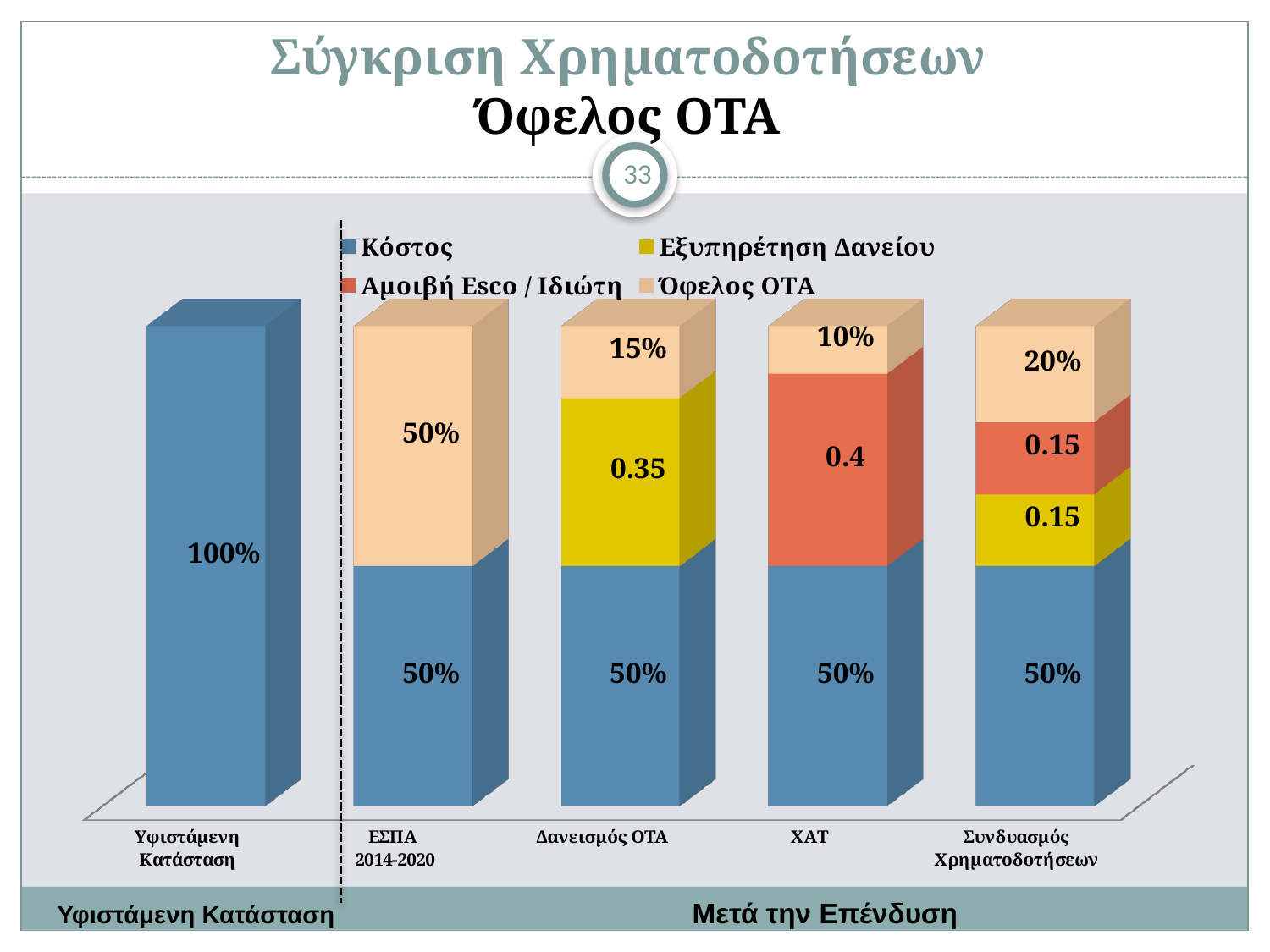
How many series does the chart legend list? 4 What is the value of Αμοιβή Esco / Ιδιώτη for ΧΑΤ? 0.4 Which category has the highest Όφελος ΟΤΑ value? ΕΣΠΑ 2014-2020 How many categories are shown along the x axis of the chart? 5 What is the value of Όφελος ΟΤΑ for ΕΣΠΑ 2014-2020? 50% What is the difference between the Όφελος ΟΤΑ for ΕΣΠΑ 2014-2020 and for Δανεισμός ΟΤΑ? 35% What is the value of Εξυπηρέτηση Δανείου for Δανεισμός ΟΤΑ? 0.35 What is the value of Όφελος ΟΤΑ for Συνδυασμός Χρηματοδοτήσεων? 20% Which category has the lowest Όφελος ΟΤΑ value? ΧΑΤ What is the value of Κόστος for Υφιστάμενη Κατάσταση? 100% Which is larger, the Όφελος ΟΤΑ for Δανεισμός ΟΤΑ or for Συνδυασμός Χρηματοδοτήσεων? Συνδυασμός Χρηματοδοτήσεων What kind of chart is shown on the slide? Stacked bar chart